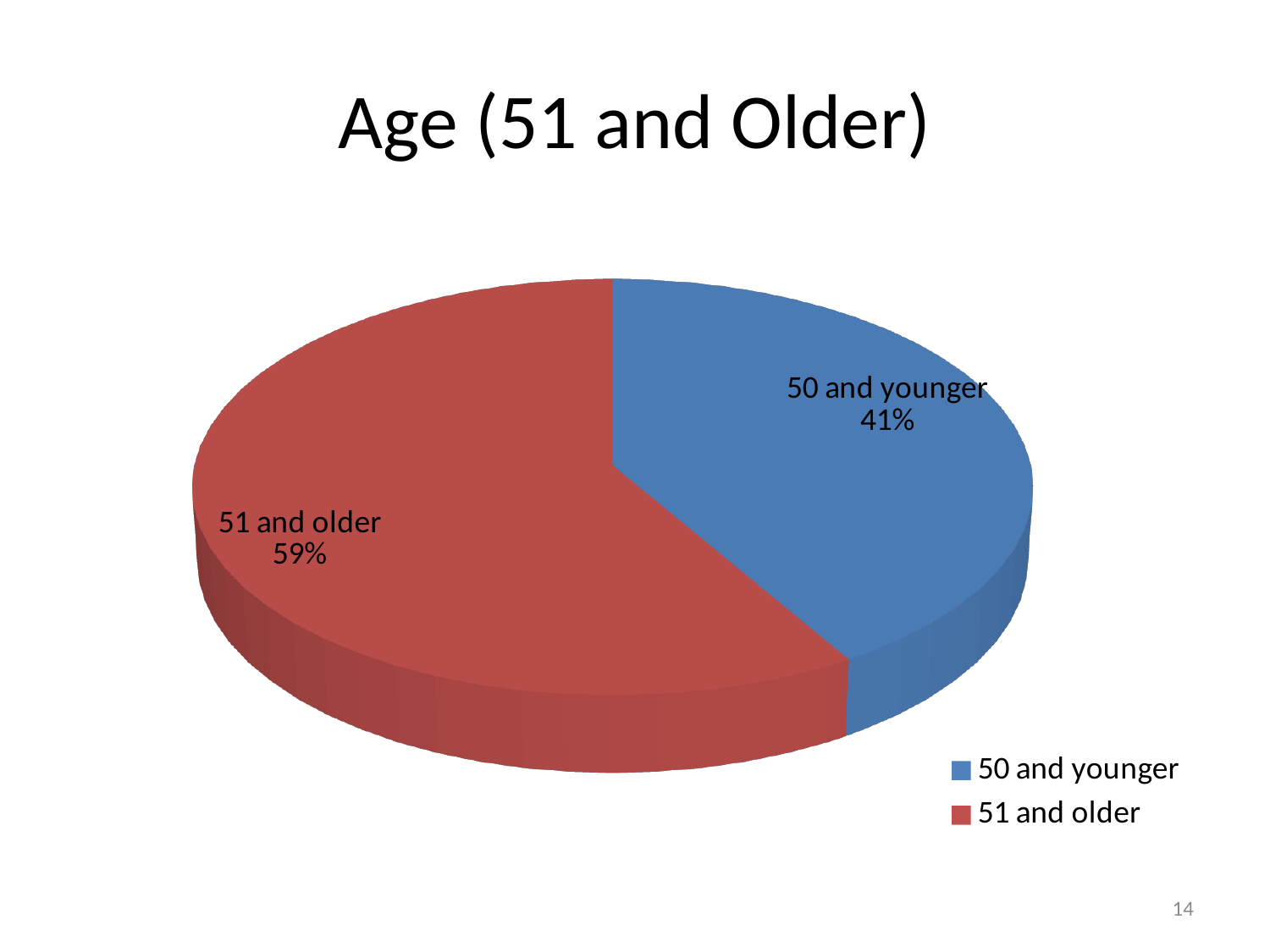
Which slice of the pie is the largest? 51 and older What colour is the "51 and older" slice? red Which is larger, the "50 and younger" slice or the "51 and older" slice? 51 and older How many entries does the legend list? 2 What share of the pie is labelled "50 and younger"? 41% How many slices does the pie chart have? 2 Which slice of the pie is the smallest? 50 and younger What is the difference in percentage points between the "51 and older" and "50 and younger" slices? 18 Is the share for "51 and older" greater or less than 50%? greater What kind of chart is shown on the slide? pie chart What is the title of the slide containing the pie chart? Age (51 and Older) What share of the pie is labelled "51 and older"? 59%